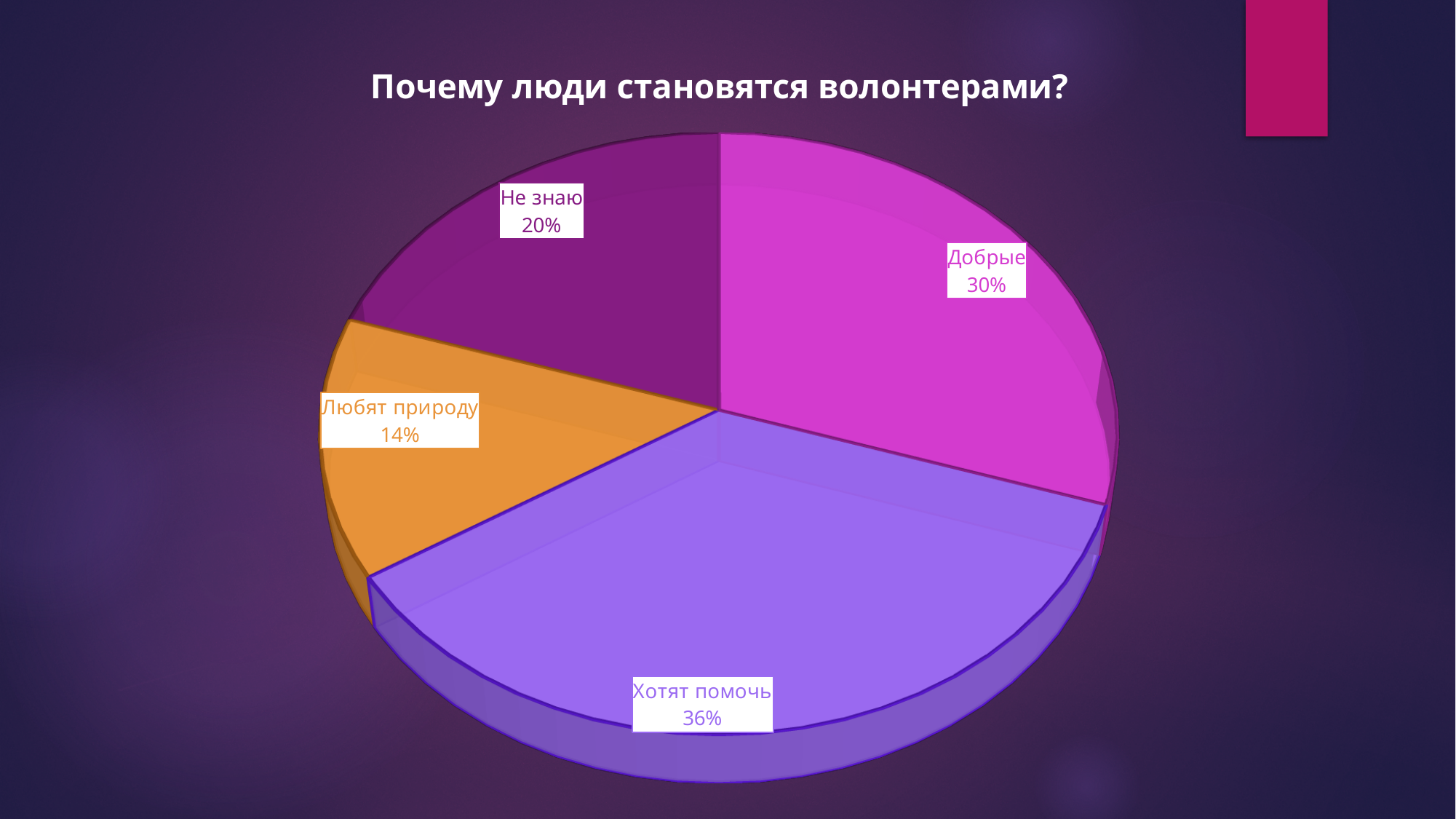
Which is larger, the "Не знаю" slice or the "Любят природу" slice? Не знаю What share of the pie is labelled "Не знаю"? 20% What share of the pie is labelled "Добрые"? 30% Which slice is the largest? Хотят помочь What colour is the "Любят природу" slice? orange What is the difference between the "Хотят помочь" and "Добрые" shares? 6% What share of the pie is labelled "Хотят помочь"? 36% What kind of chart is shown on the slide? pie chart How many slices does the pie chart have? 4 What is the title of the chart? Почему люди становятся волонтерами? Which slice is the smallest? Любят природу